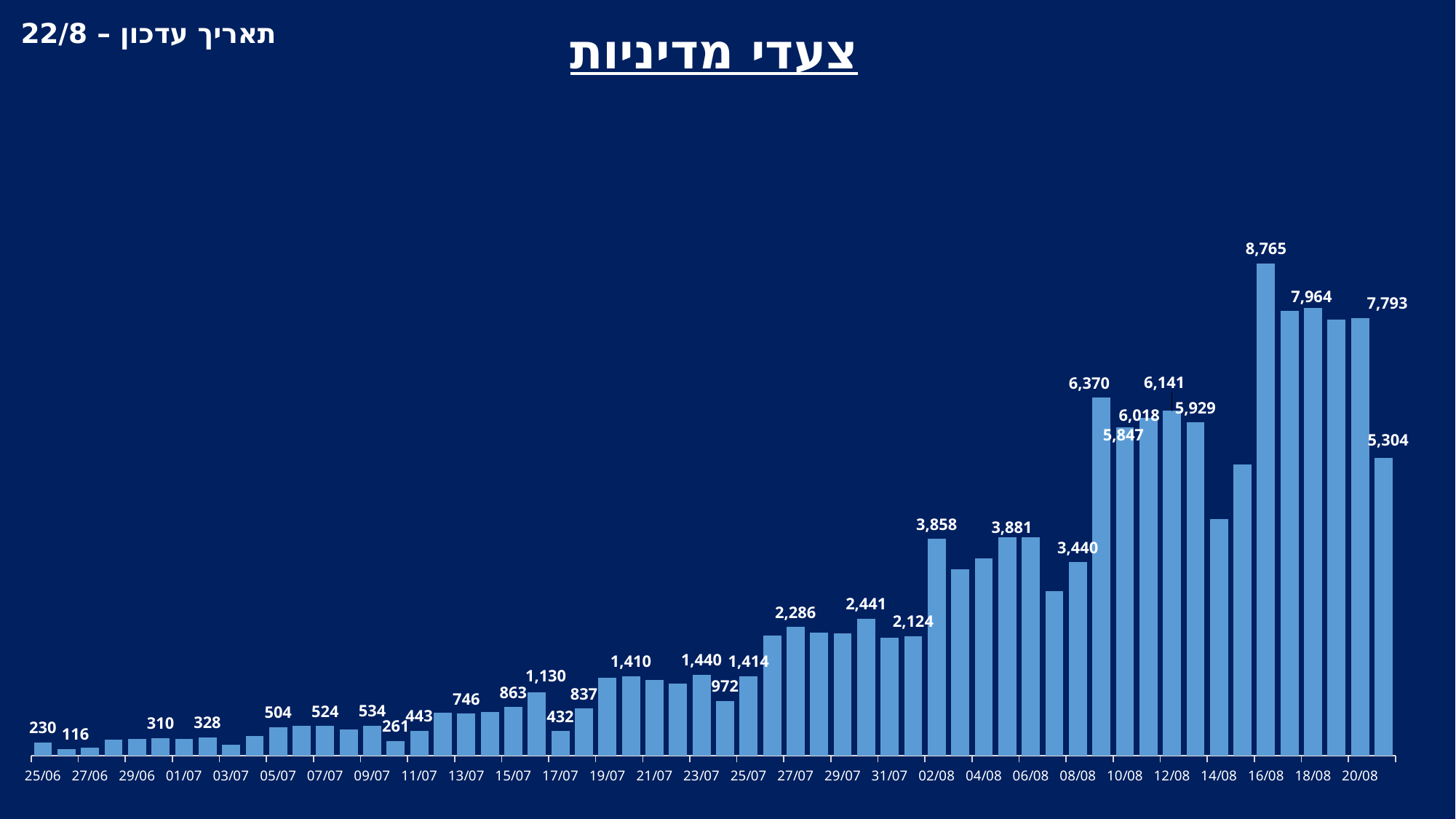
What is the lowest labelled value in the chart? 116 What is the title of the chart? צעדי מדיניות What is the difference between the first bar (230) and the second bar (116)? 114 Do the values generally rise or fall from 25/06 to 20/08? rise Which is larger, the value for 16/08 or the value for 18/08? 16/08 What is the difference between the 16/08 value (8,765) and the 18/08 value (7,964)? 801 What is the value of the first bar, for 25/06? 230 What update date is shown in the top-left corner of the slide? 22/8 What is the value of the last bar in the chart? 5,304 What kind of chart is shown on the slide? bar chart Which date has the highest value in the chart? 16/08 What is the value of the tallest bar, for 16/08? 8,765